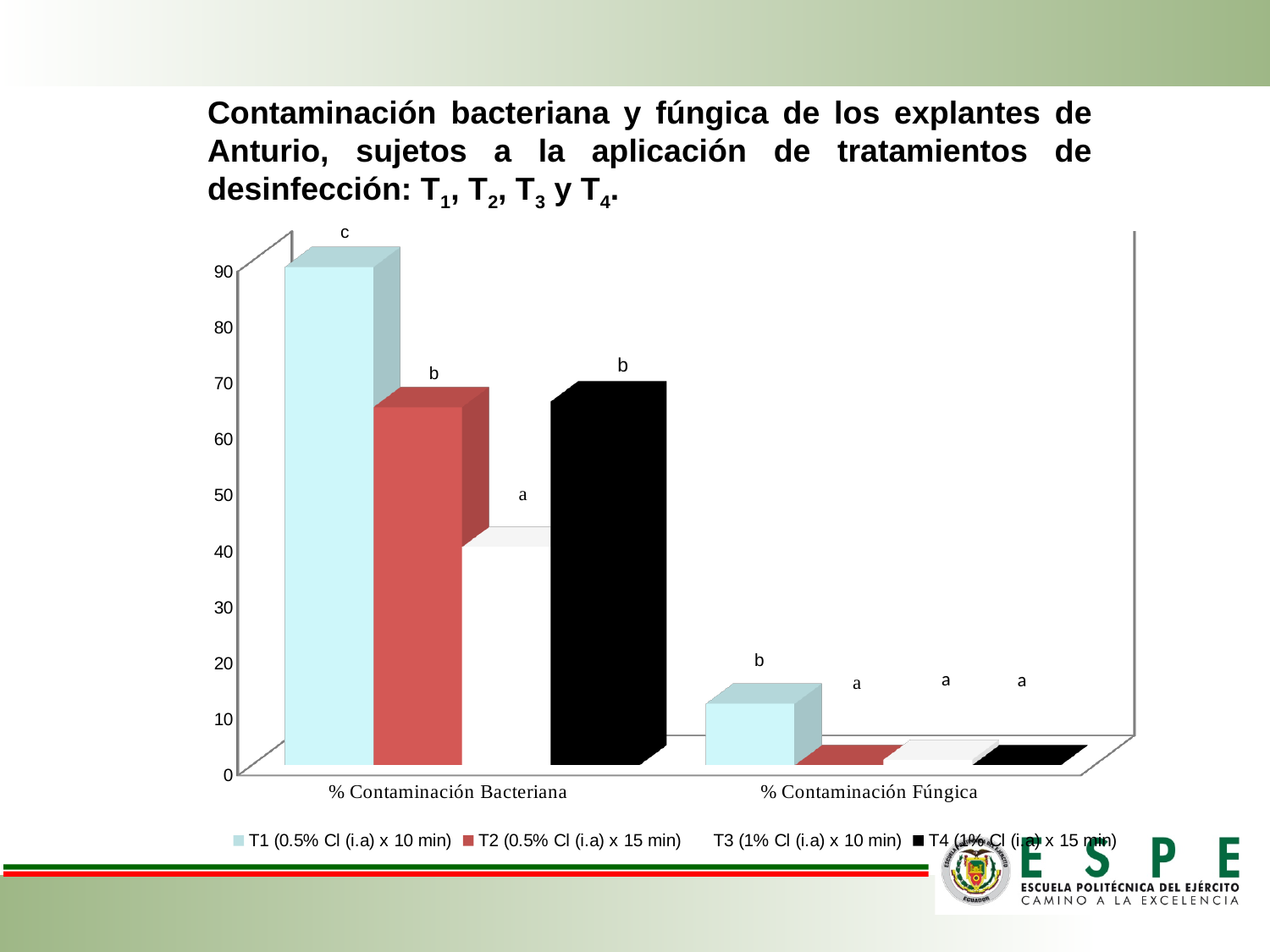
How many categories are shown on the x axis? 2 Is the value of T1 for % Contaminación Bacteriana greater or less than 80? greater Which treatment has the highest value for % Contaminación Bacteriana? T1 (0.5% Cl (i.a) x 10 min) What letter label appears above the T1 bar for % Contaminación Bacteriana? c For T1, which is larger: % Contaminación Bacteriana or % Contaminación Fúngica? % Contaminación Bacteriana What kind of chart is shown on the slide? bar chart How many series does the legend list? 4 Is the value of T3 for % Contaminación Bacteriana greater or less than 50? less Is the value of T2 for % Contaminación Bacteriana greater or less than 50? greater Which treatment has the lowest value for % Contaminación Bacteriana? T3 (1% Cl (i.a) x 10 min) Which treatment has the highest value for % Contaminación Fúngica? T1 (0.5% Cl (i.a) x 10 min)